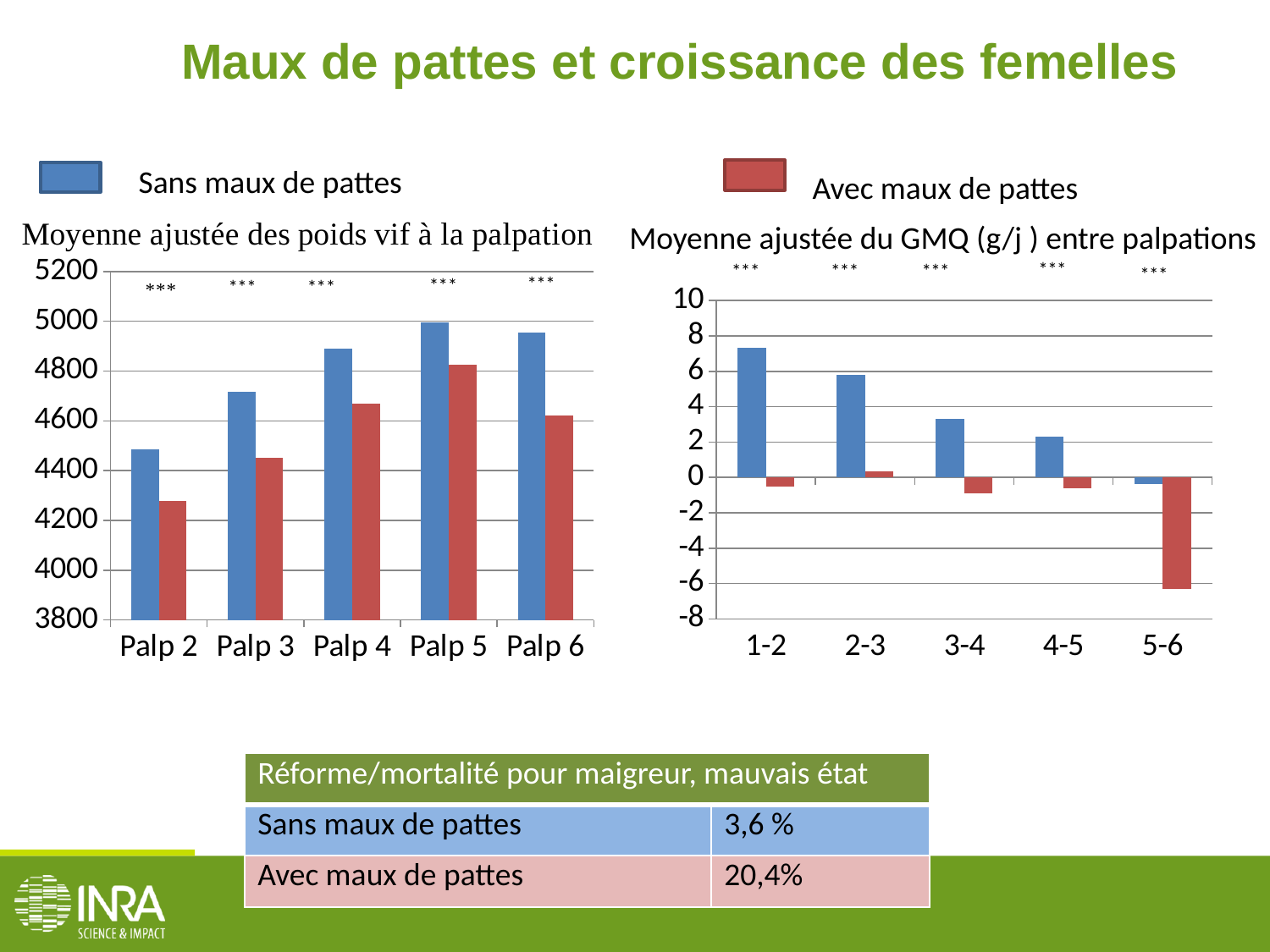
In the right chart, 'Moyenne ajustée du GMQ (g/j ) entre palpations', for which interval is the Avec maux de pattes value lowest? 5-6 In the right chart, 'Moyenne ajustée du GMQ (g/j ) entre palpations', do the Sans maux de pattes values rise or fall from 1-2 to 5-6? fall In the left chart, 'Moyenne ajustée des poids vif à la palpation', at which palpation is the Avec maux de pattes value highest? Palp 5 In the left chart, 'Moyenne ajustée des poids vif à la palpation', at Palp 4 which series has the larger value, Sans maux de pattes or Avec maux de pattes? Sans maux de pattes In the left chart, 'Moyenne ajustée des poids vif à la palpation', is the value for Avec maux de pattes at Palp 5 greater or less than 4600? greater In the right chart, 'Moyenne ajustée du GMQ (g/j ) entre palpations', for which interval is the Sans maux de pattes value highest? 1-2 In the left chart, 'Moyenne ajustée des poids vif à la palpation', is the value for Sans maux de pattes at Palp 2 greater or less than 4600? less How many categories are shown on the x axis of the left chart, 'Moyenne ajustée des poids vif à la palpation'? 5 How many series does the legend at the top of the slide list? 2 In the left chart, 'Moyenne ajustée des poids vif à la palpation', at which palpation is the Sans maux de pattes value lowest? Palp 2 What kind of chart is the left chart, 'Moyenne ajustée des poids vif à la palpation'? bar chart In the right chart, 'Moyenne ajustée du GMQ (g/j ) entre palpations', is the value for Sans maux de pattes at 1-2 greater or less than 6? greater